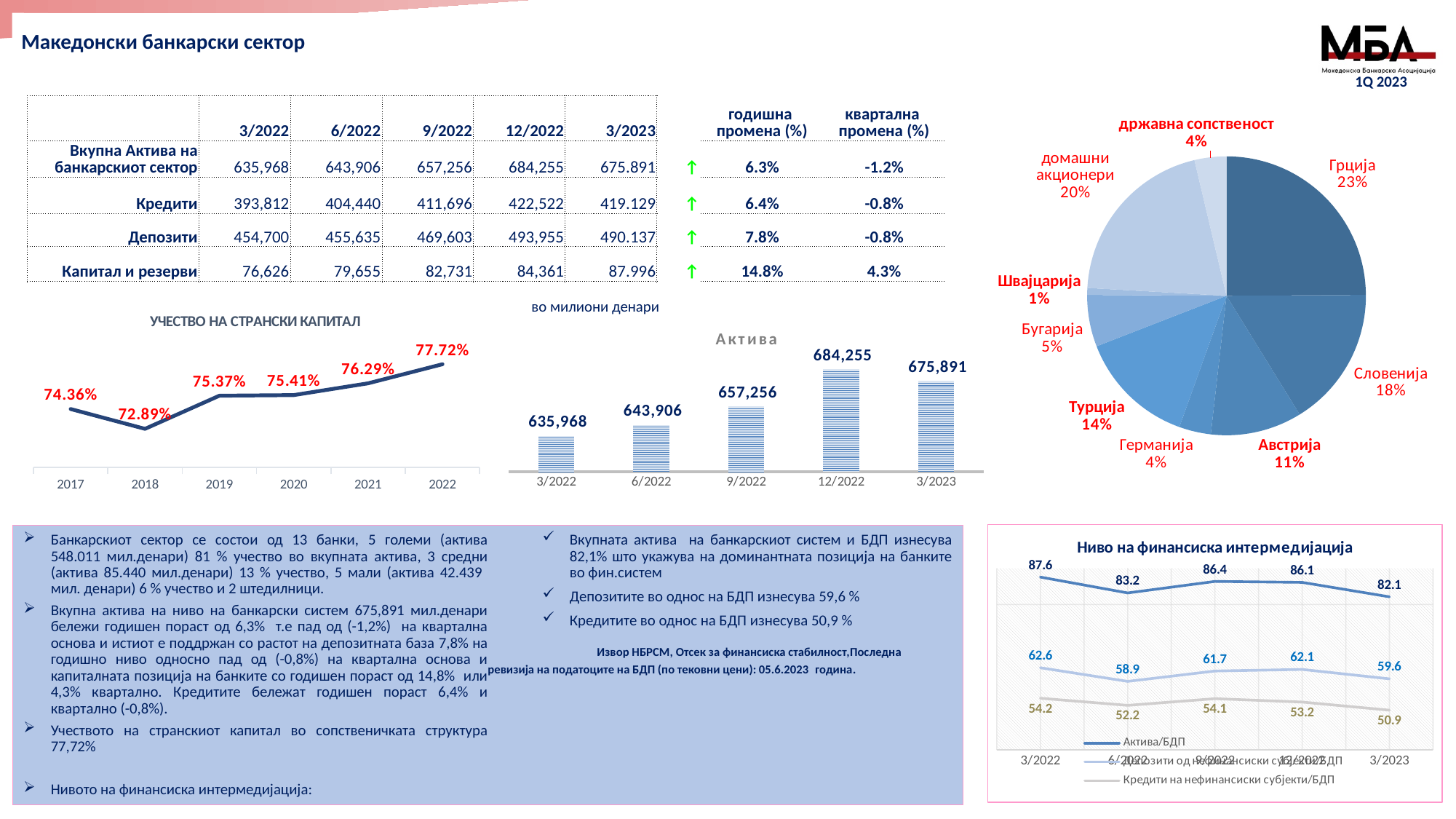
How many series does the legend of the 'Ниво на финансиска интермедијација' chart list? 3 In the pie chart at the top right, what share does Грција have? 23% In the 'Актива' bar chart, which period has the highest value? 12/2022 In the 'Актива' bar chart, what is the value for 12/2022? 684,255 In the pie chart at the top right, which is larger: Турција or Австрија? Турција In the 'УЧЕСТВО НА СТРАНСКИ КАПИТАЛ' line chart, which year has the lowest value? 2018 In the 'УЧЕСТВО НА СТРАНСКИ КАПИТАЛ' line chart, how many years are plotted? 6 In the 'Актива' bar chart, what is the difference between the values for 12/2022 and 3/2023? 8,364 What kind of chart is the 'Актива' chart? Bar chart In the 'Ниво на финансиска интермедијација' chart, what is the value of Актива/БДП for 3/2023? 82.1 In the pie chart at the top right, which slice is the smallest? Швајцарија In the 'УЧЕСТВО НА СТРАНСКИ КАПИТАЛ' line chart, what is the value for 2022? 77.72%